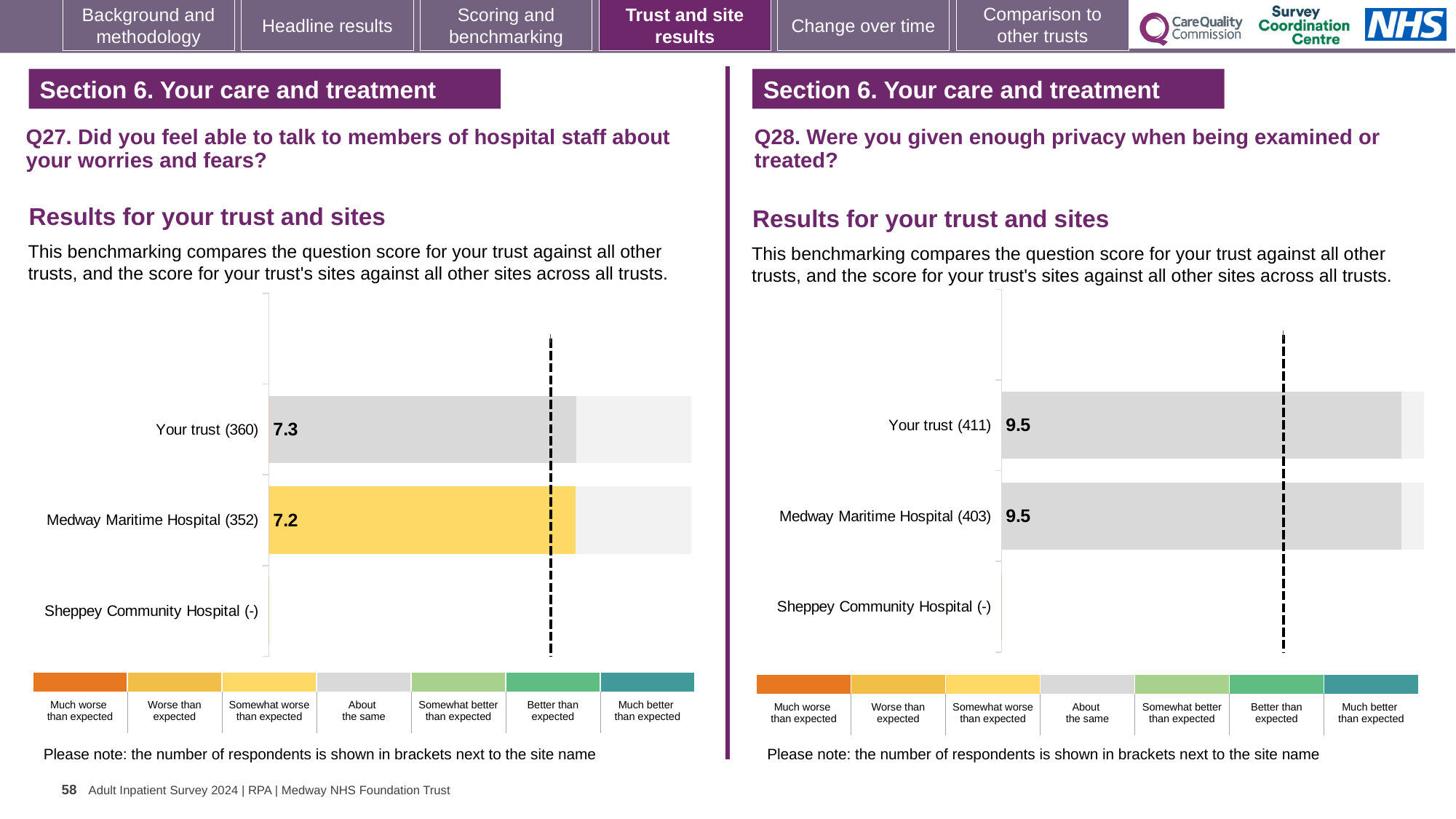
How many categories are listed on the Q27 chart (left)? 3 On the Q27 chart (left), which category has no score shown? Sheppey Community Hospital (-) On the Q28 chart (right), how many respondents are shown in brackets for Medway Maritime Hospital? 403 On the Q27 chart (left), what is the difference between the score for Your trust and the score for Medway Maritime Hospital? 0.1 On the Q27 chart (left), which has the higher score, Your trust or Medway Maritime Hospital? Your trust On the Q28 chart (right), what is the score for Medway Maritime Hospital (403)? 9.5 What kind of chart is the Q28 chart (right)? Bar chart On the Q28 chart (right), what is the difference between the score for Your trust and the score for Medway Maritime Hospital? 0 On the Q27 chart (left), what colour is the bar for Medway Maritime Hospital? Yellow On the Q28 chart (right), what is the score for Your trust (411)? 9.5 On the Q27 chart (left), what is the score for Your trust (360)? 7.3 On the Q27 chart (left), what is the score for Medway Maritime Hospital (352)? 7.2